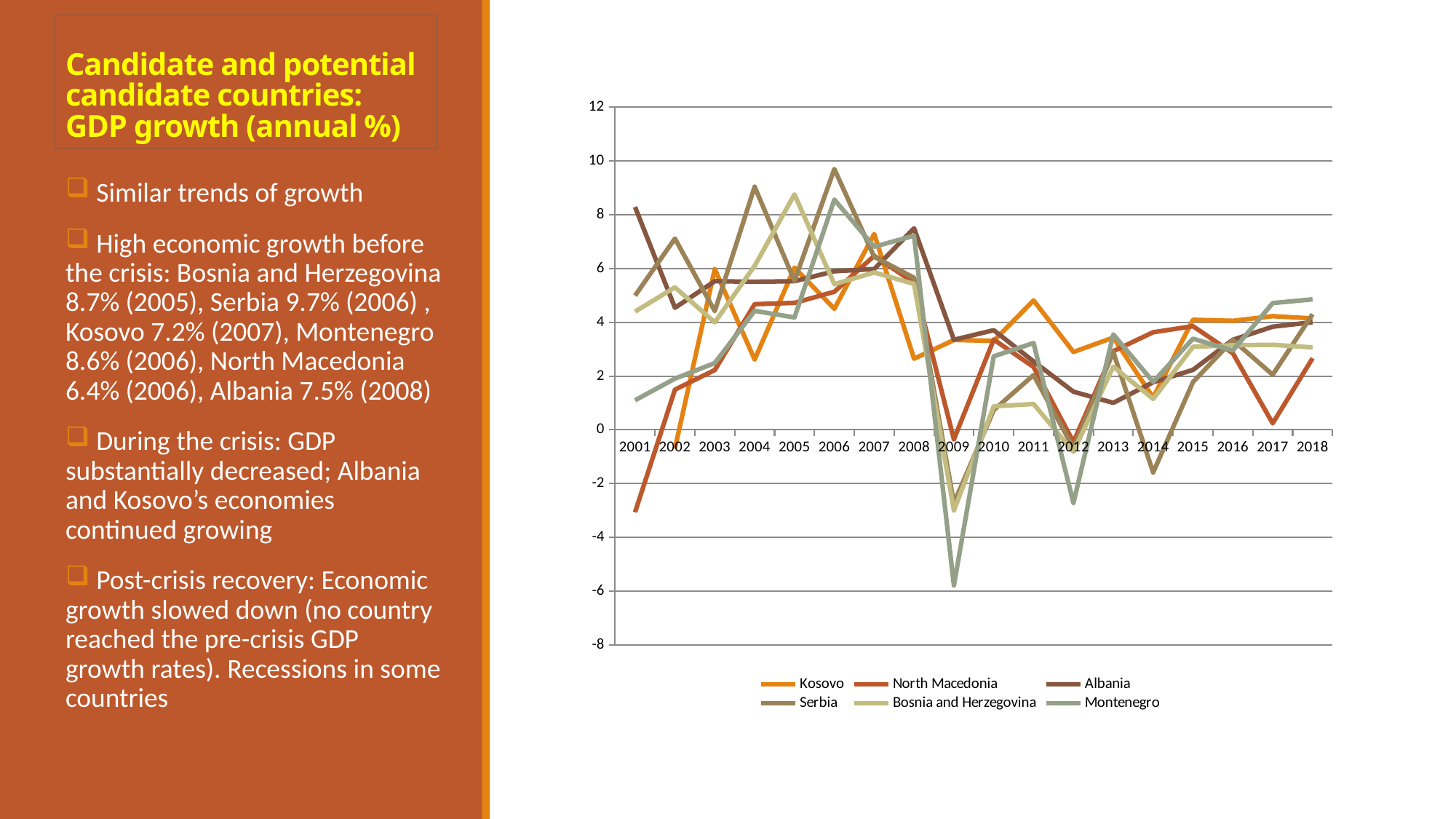
Is the value for North Macedonia in 2001 greater or less than -2? less What is the title of the slide that describes the chart? Candidate and potential candidate countries: GDP growth (annual %) How many years are shown on the x axis? 18 Which is larger in 2006, the value for Serbia or the value for North Macedonia? Serbia What kind of chart is shown on the slide? line chart Is the value for Montenegro in 2009 greater or less than -4? less Does the value for Serbia rise or fall from 2006 to 2009? fall Is the value for Bosnia and Herzegovina in 2005 greater or less than 8? greater How many series does the legend list? 6 Which country has the lowest value in 2009? Montenegro Which country has the highest value in 2006? Serbia